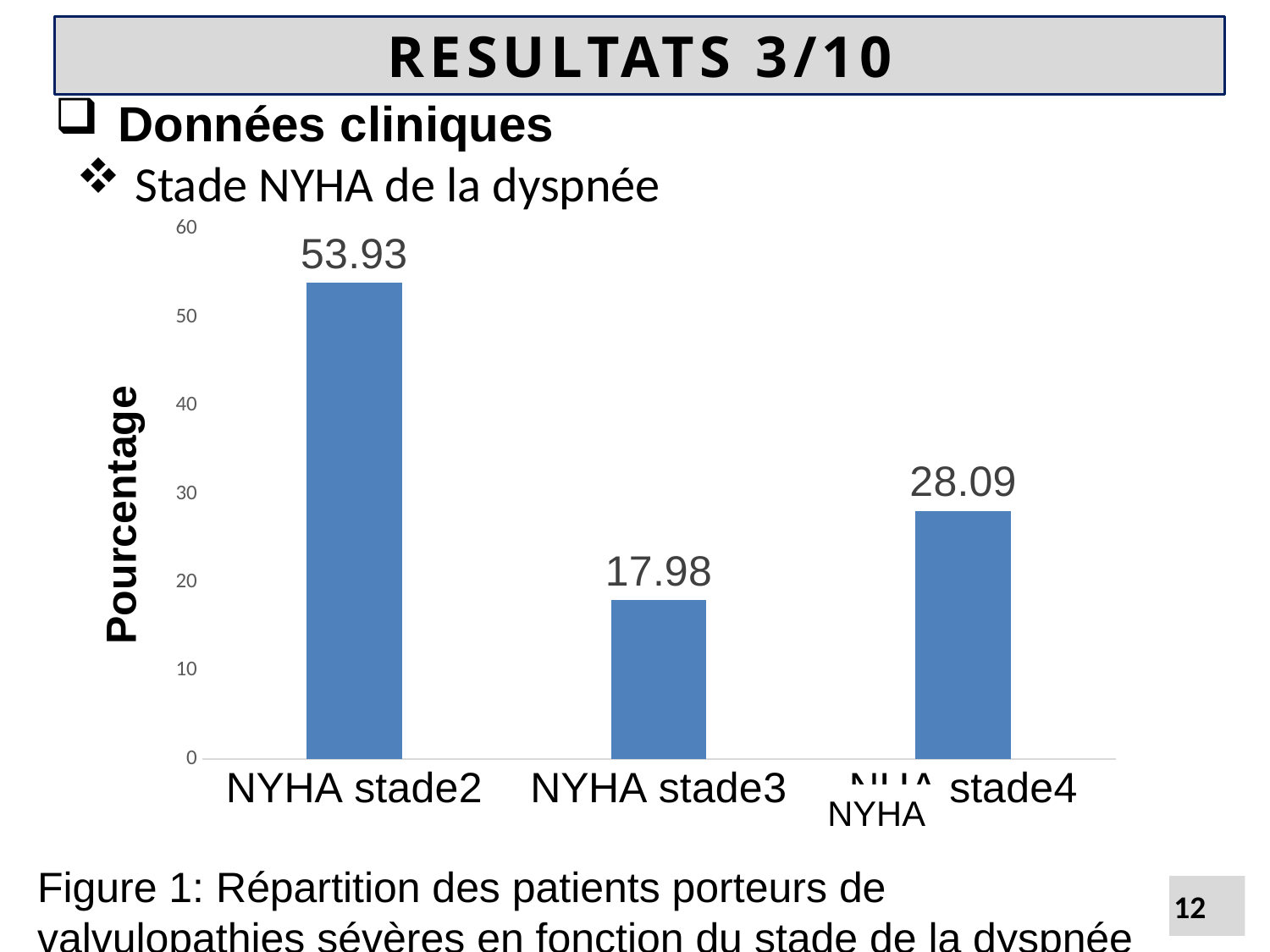
Which is larger, the value for NYHA stade4 or NYHA stade3? NYHA stade4 What is the value for NYHA stade3? 17.98 What is the value for NYHA stade4? 28.09 What is the difference between the values for NYHA stade2 and NYHA stade3? 35.95 Which NYHA stage has the lowest percentage? NYHA stade3 Which NYHA stage has the highest percentage? NYHA stade2 How many categories are shown on the x axis of the chart? 3 What is the difference between the values for NYHA stade4 and NYHA stade3? 10.11 What is the value for NYHA stade2? 53.93 What is the label of the vertical axis of the chart? Pourcentage What kind of chart is shown on the slide? bar chart Is the value for NYHA stade2 greater or less than 50? greater